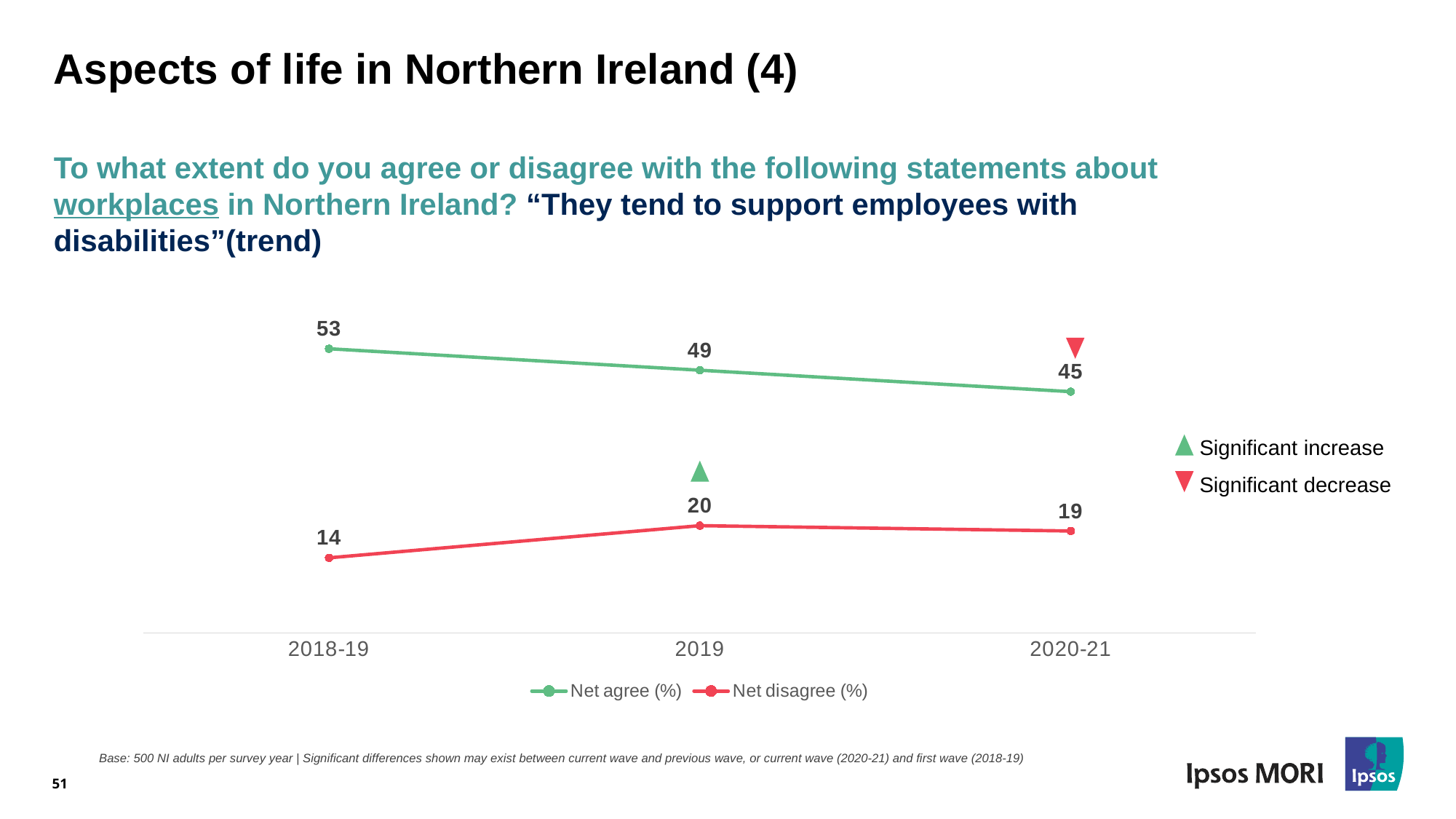
Which is larger in 2019: Net agree (%) or Net disagree (%)? Net agree (%) What is the Net agree (%) value for 2020-21? 45 In which year is Net agree (%) highest? 2018-19 What is the Net disagree (%) value for 2019? 20 In which year is Net disagree (%) lowest? 2018-19 How many survey years are shown on the x axis? 3 How many series does the chart legend list? 2 Does Net agree (%) rise or fall from 2018-19 to 2020-21? Fall What kind of chart is shown on the slide? Line chart What is the difference between Net agree (%) in 2018-19 and 2020-21? 8 What is the Net agree (%) value for 2018-19? 53 What is the Net disagree (%) value for 2020-21? 19